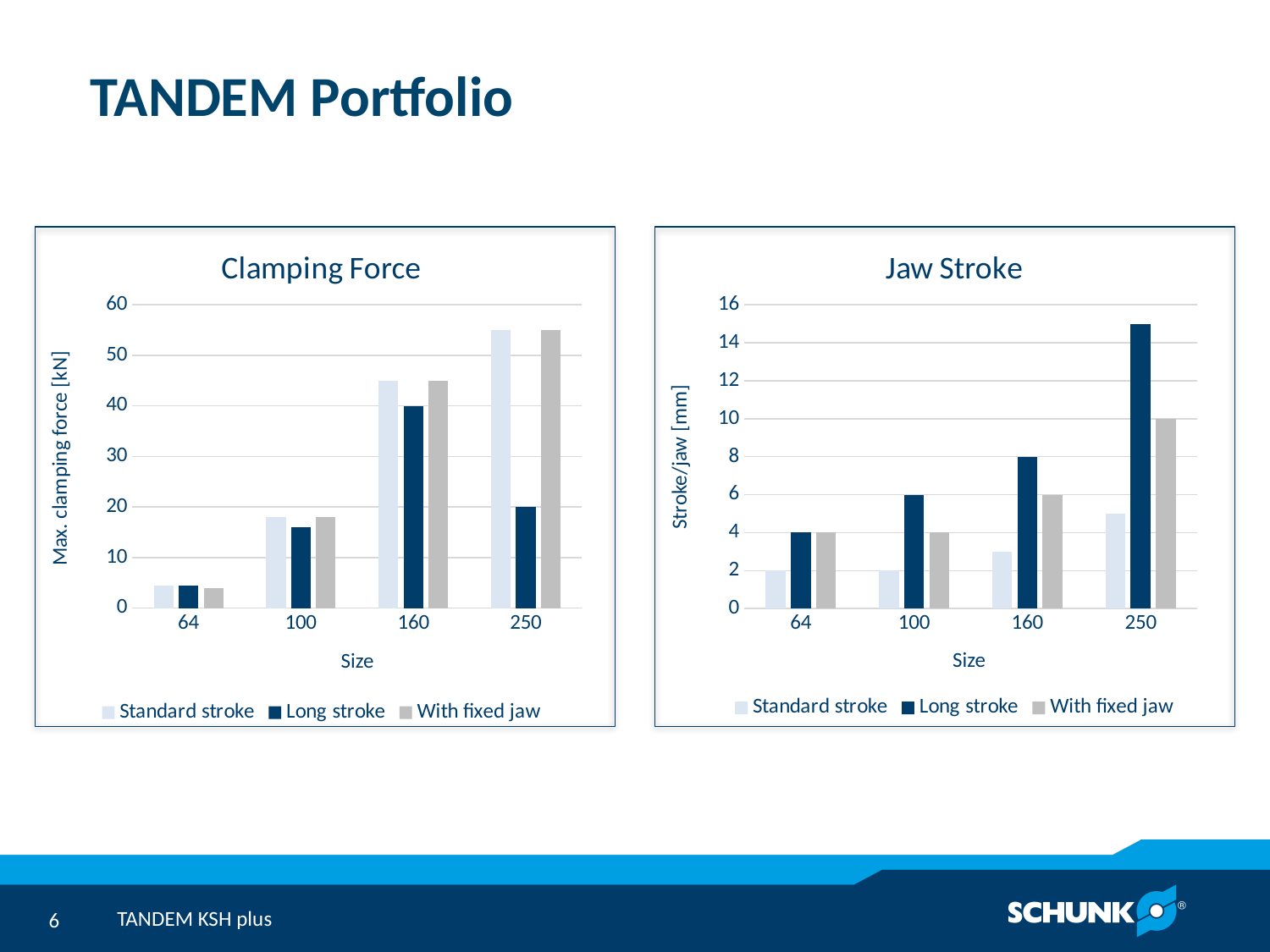
In the Jaw Stroke chart, does the Long stroke value rise or fall as size increases from 64 to 250? rise In the Jaw Stroke chart, which series and size has the highest bar? Long stroke at size 250 How many series does the legend of the Jaw Stroke chart list? 3 In the Clamping Force chart, what is the Long stroke value for size 250? 20 In the Clamping Force chart, is the Standard stroke value for size 250 greater or less than 50? greater In the Clamping Force chart, which size has the lowest clamping force values? 64 In the Jaw Stroke chart, what is the difference between the Long stroke and With fixed jaw values for size 160? 2 In the Clamping Force chart, what is the Long stroke value for size 160? 40 In the Jaw Stroke chart, what is the Standard stroke value for size 64? 2 In the Jaw Stroke chart, what is the Long stroke value for size 160? 8 In the Jaw Stroke chart, is the Long stroke value for size 250 greater or less than 14? greater In the Jaw Stroke chart, what is the With fixed jaw value for size 250? 10